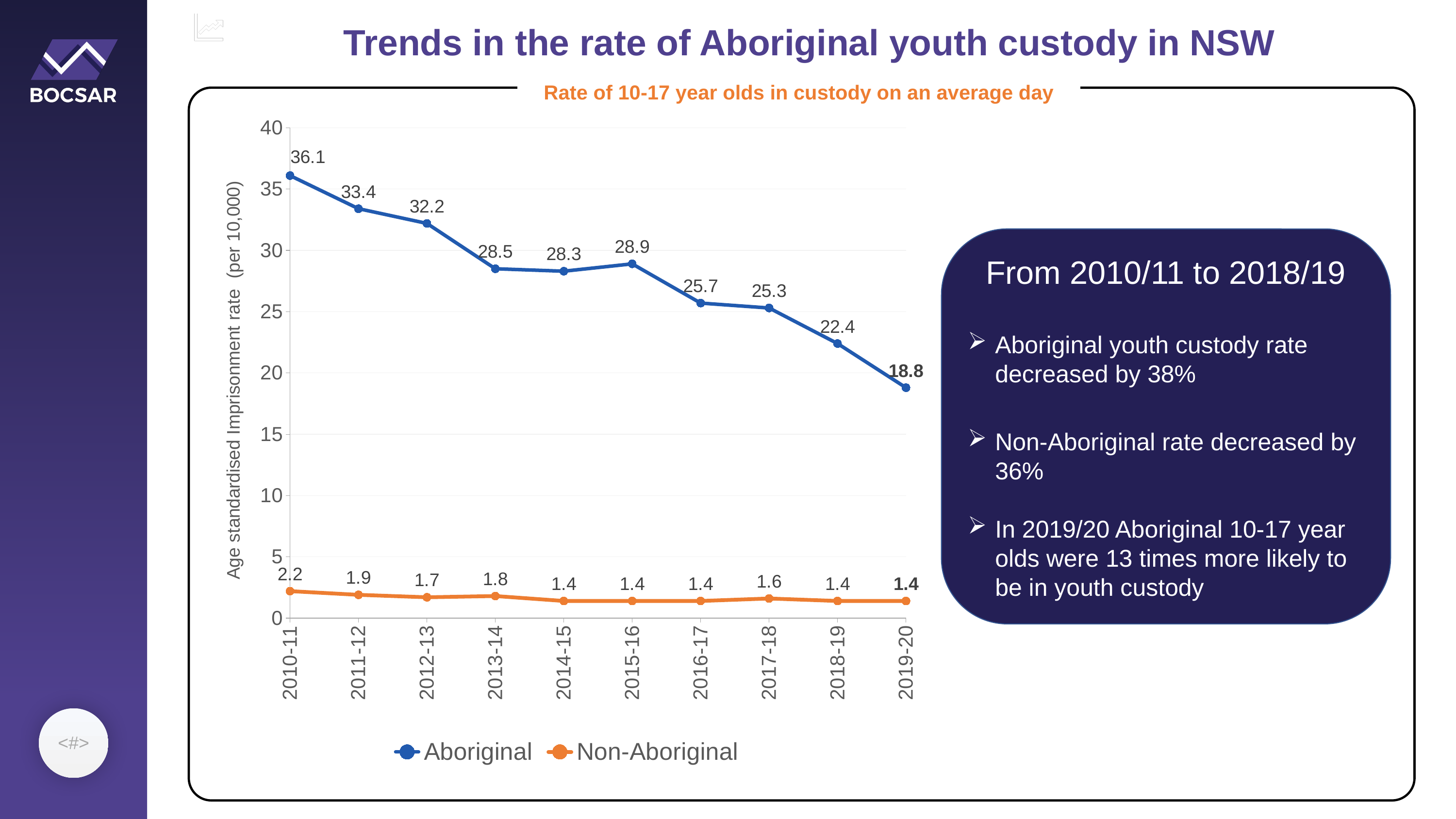
What is the Aboriginal youth custody rate in 2010-11? 36.1 How many series does the legend list? 2 What kind of chart is shown? line chart What is the Non-Aboriginal youth custody rate in 2019-20? 1.4 What is the Aboriginal rate in 2015-16? 28.9 In which year is the Non-Aboriginal rate highest? 2010-11 What is the difference between the Aboriginal rate in 2010-11 and in 2019-20? 17.3 Does the Aboriginal rate generally rise or fall from 2010-11 to 2019-20? fall How many years are shown on the x axis? 10 Which is larger, the Aboriginal rate in 2013-14 or in 2015-16? 2015-16 Is the Aboriginal rate in 2018-19 greater or less than 25? less In which year is the Aboriginal rate lowest? 2019-20